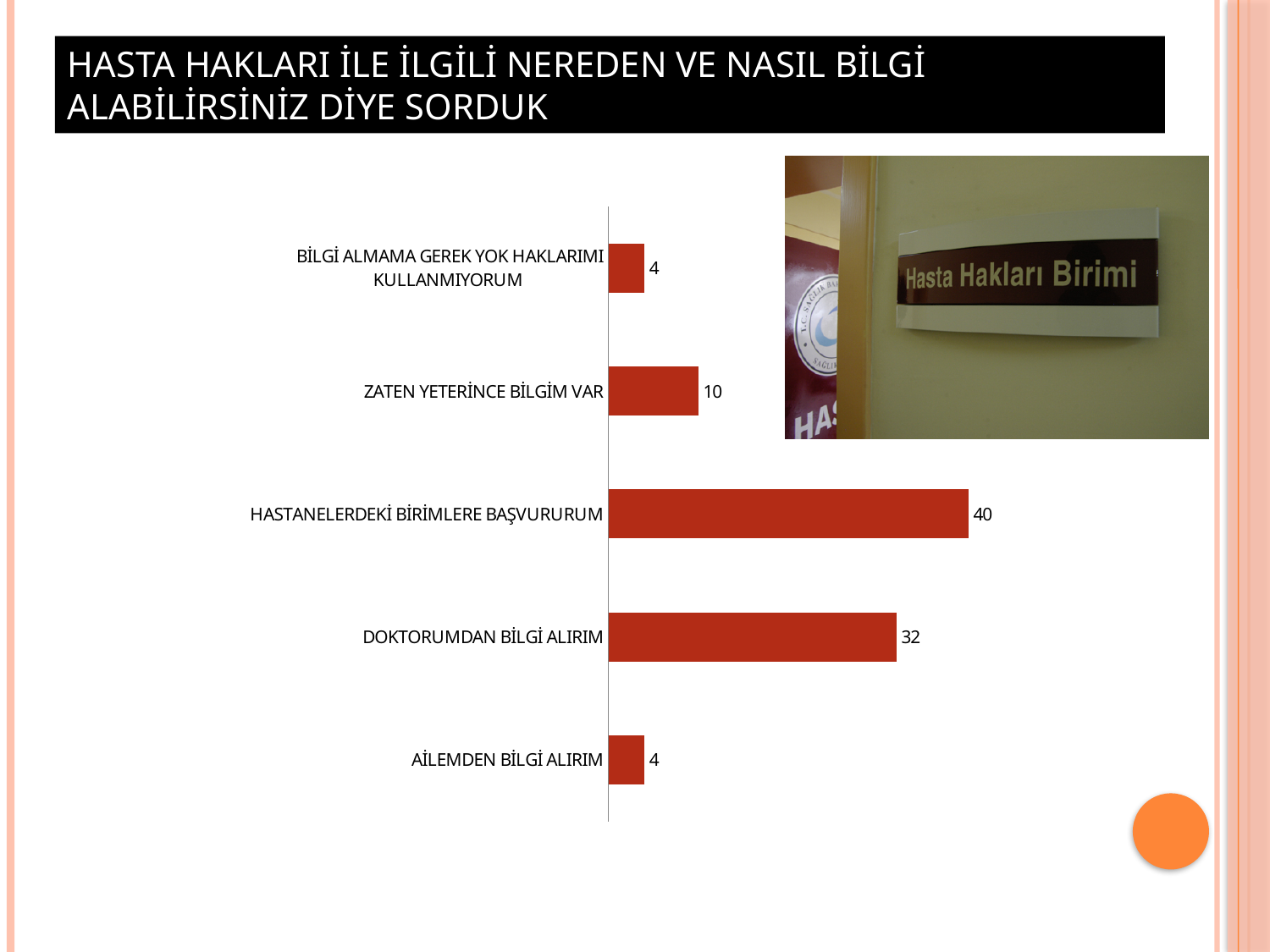
Which category has the highest value? HASTANELERDEKİ BİRİMLERE BAŞVURURUM What value is shown for BİLGİ ALMAMA GEREK YOK HAKLARIMI KULLANMIYORUM? 4 What value is shown for AİLEMDEN BİLGİ ALIRIM? 4 What is the difference between the values for ZATEN YETERİNCE BİLGİM VAR and AİLEMDEN BİLGİ ALIRIM? 6 What value is shown for HASTANELERDEKİ BİRİMLERE BAŞVURURUM? 40 What value is shown for DOKTORUMDAN BİLGİ ALIRIM? 32 Which is larger, the value for DOKTORUMDAN BİLGİ ALIRIM or the value for ZATEN YETERİNCE BİLGİM VAR? DOKTORUMDAN BİLGİ ALIRIM What colour are the bars in the chart? Red What kind of chart is shown on the slide? Bar chart What is the difference between the values for HASTANELERDEKİ BİRİMLERE BAŞVURURUM and DOKTORUMDAN BİLGİ ALIRIM? 8 How many categories are shown in the chart? 5 What value is shown for ZATEN YETERİNCE BİLGİM VAR? 10